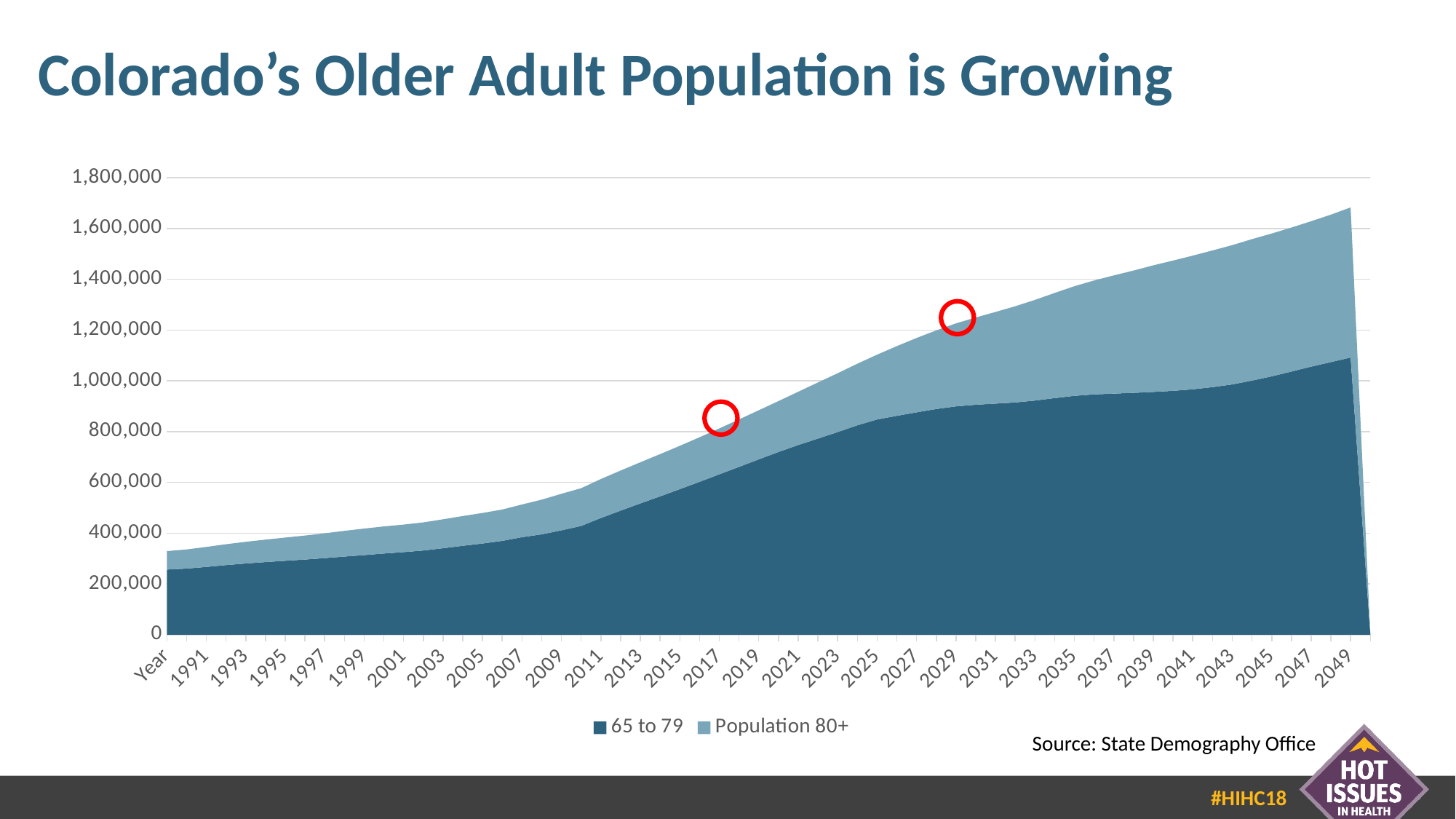
How many series does the legend list? 2 Is the value for the 65 to 79 series in 2049 greater or less than 1,000,000? greater Is the total older adult population in 1991 greater or less than 400,000? less Does the total older adult population rise or fall from 1991 to 2049? Rises Which series is larger in 2049, 65 to 79 or Population 80+? 65 to 79 Is the value for the 65 to 79 series in 2011 greater or less than 600,000? less What kind of chart is shown on the slide? Stacked area chart What is the title of the chart? Colorado's Older Adult Population is Growing What are the two series named in the legend? 65 to 79 and Population 80+